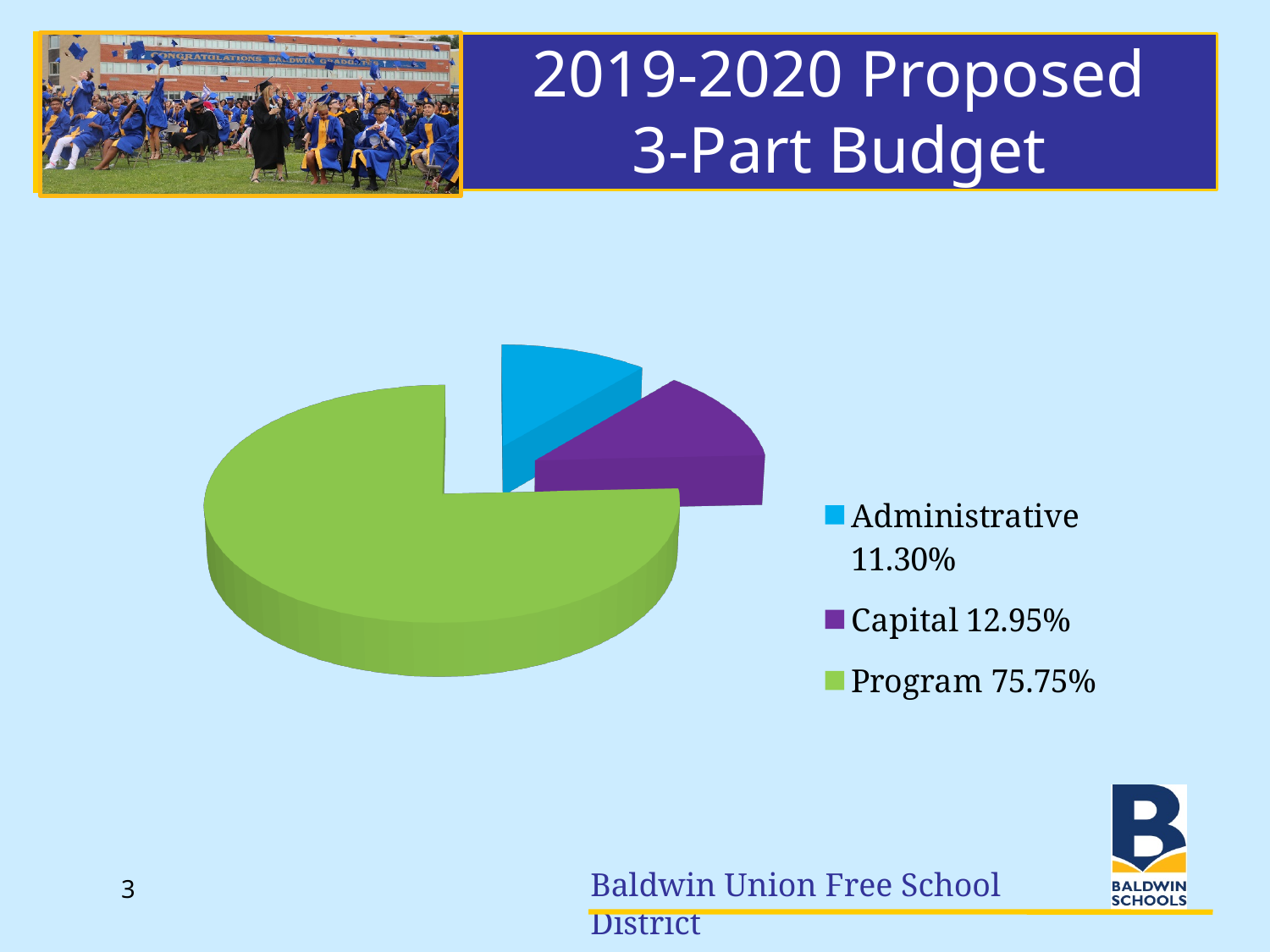
What is the difference between the Capital share and the Administrative share? 1.65% What share of the budget is Administrative? 11.30% Which is larger, the Capital share or the Administrative share? Capital Which category has the largest share of the budget? Program What colour is the Capital slice of the pie chart? purple What colour is the Program slice of the pie chart? green What share of the budget is Program? 75.75% Which category has the smallest share of the budget? Administrative What share of the budget is Capital? 12.95% What is the difference between the Program share and the Capital share? 62.80% What kind of chart is shown on the slide? pie chart How many categories does the pie chart show? 3